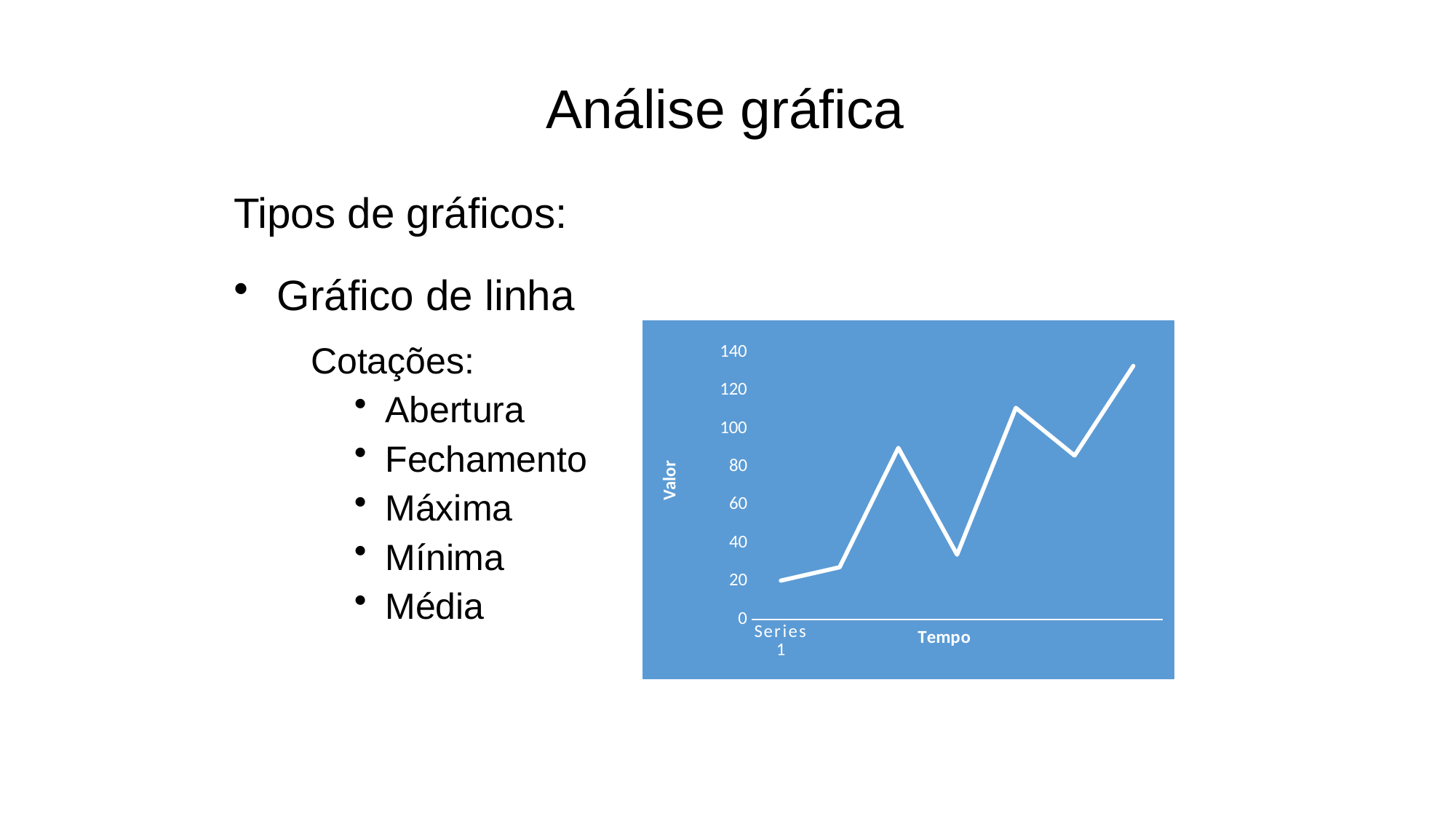
What is the label of the horizontal axis of the chart? Tempo What kind of chart is shown on the slide? line chart Is the value of the fourth point on the line greater or less than 40? less Is the value of the fifth point on the line greater or less than 100? greater Is the value of the third point on the line greater or less than 80? greater How many data points are plotted on the line? 7 What is the label of the vertical axis of the chart? Valor Overall, do the values rise or fall from left to right along the x axis? rise Which point on the line has the highest value? the last (rightmost) point Which point on the line has the lowest value? the first (leftmost) point